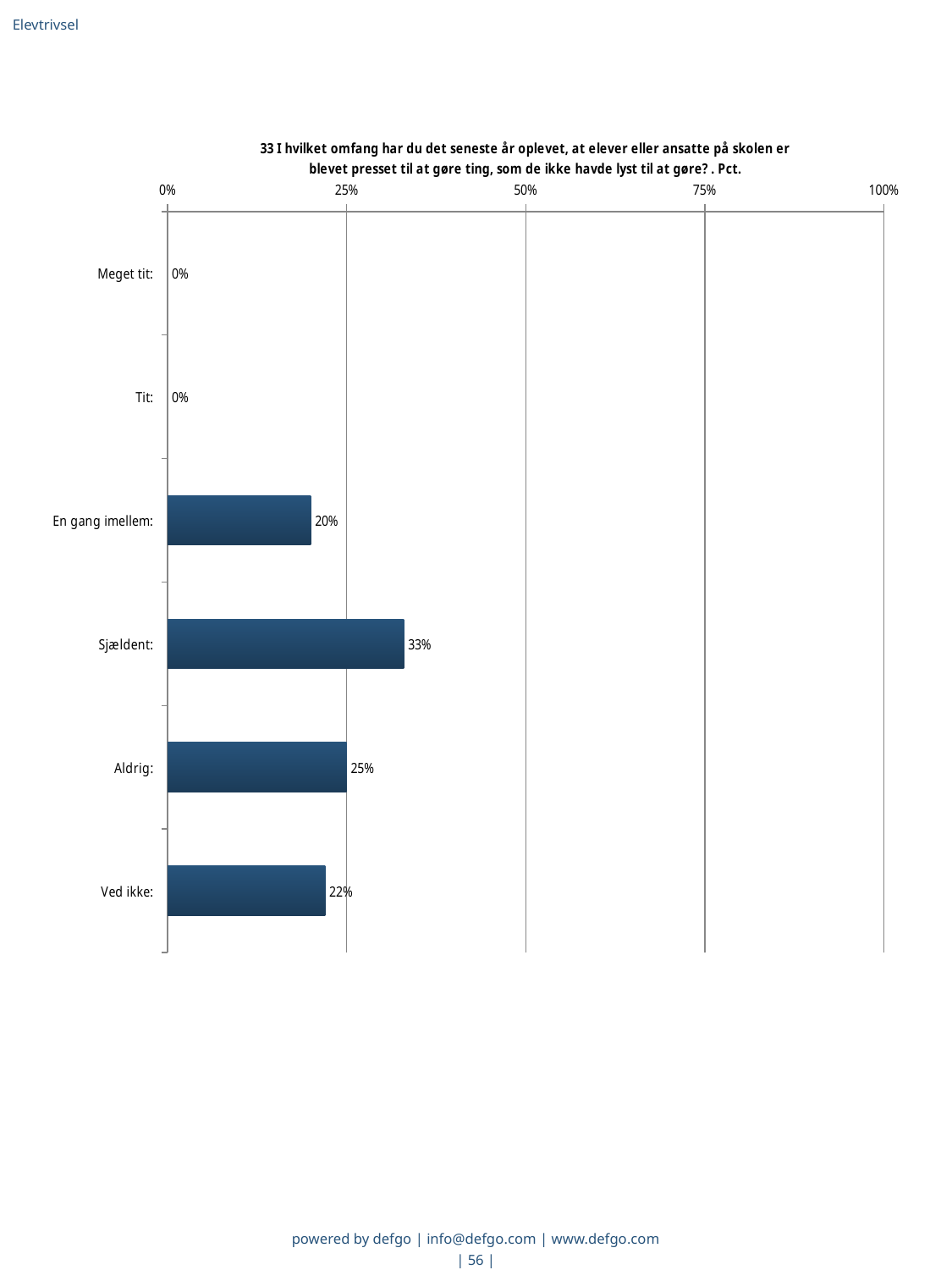
What is the value for "Ved ikke:"? 22% How many categories are shown on the chart? 6 What kind of chart is shown on the slide? bar chart What is the value for "Sjældent:"? 33% Which category has the highest value? Sjældent: What is the value for "Aldrig:"? 25% Which is larger, the value for "Aldrig:" or the value for "Ved ikke:"? Aldrig: What is the value for "En gang imellem:"? 20% How many categories have a value of 0%? 2 Is the value for "Sjældent:" greater or less than 25%? greater What is the difference between the values for "Sjældent:" and "Aldrig:"? 8% What is the maximum value shown on the horizontal axis? 100%